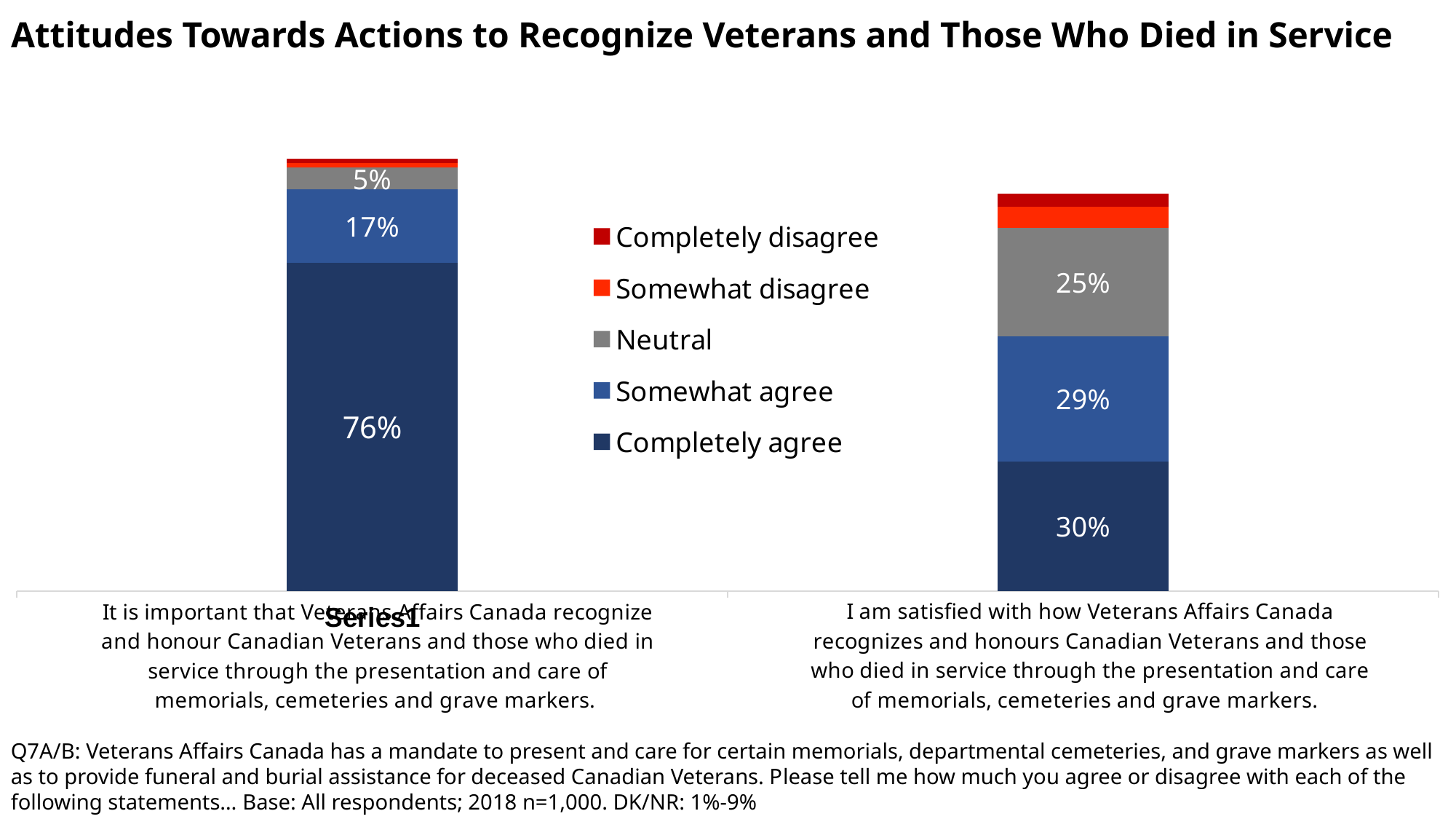
What percentage of respondents are neutral on the statement 'I am satisfied with how Veterans Affairs Canada recognizes and honours Canadian Veterans...'? 25% What percentage of respondents somewhat agree with the statement 'It is important that Veterans Affairs Canada recognize and honour Canadian Veterans...'? 17% What percentage of respondents completely agree that it is important that Veterans Affairs Canada recognize and honour Canadian Veterans through memorials, cemeteries and grave markers? 76% What percentage of respondents completely agree that they are satisfied with how Veterans Affairs Canada recognizes and honours Canadian Veterans? 30% Which statement has the larger 'Somewhat agree' share: the importance statement or the satisfaction statement? The satisfaction statement What percentage of respondents somewhat agree that they are satisfied with how Veterans Affairs Canada recognizes and honours Canadian Veterans? 29% How many response categories does the legend list? 5 How much higher is the 'Completely agree' share for the importance statement than for the satisfaction statement? 46 percentage points What is the difference between the 'Neutral' shares for the satisfaction statement and the importance statement? 20 percentage points What percentage of respondents are neutral on the statement 'It is important that Veterans Affairs Canada recognize and honour Canadian Veterans...'? 5% How many statements (bars) are shown in the chart? 2 What type of chart is shown on the slide? Stacked bar chart